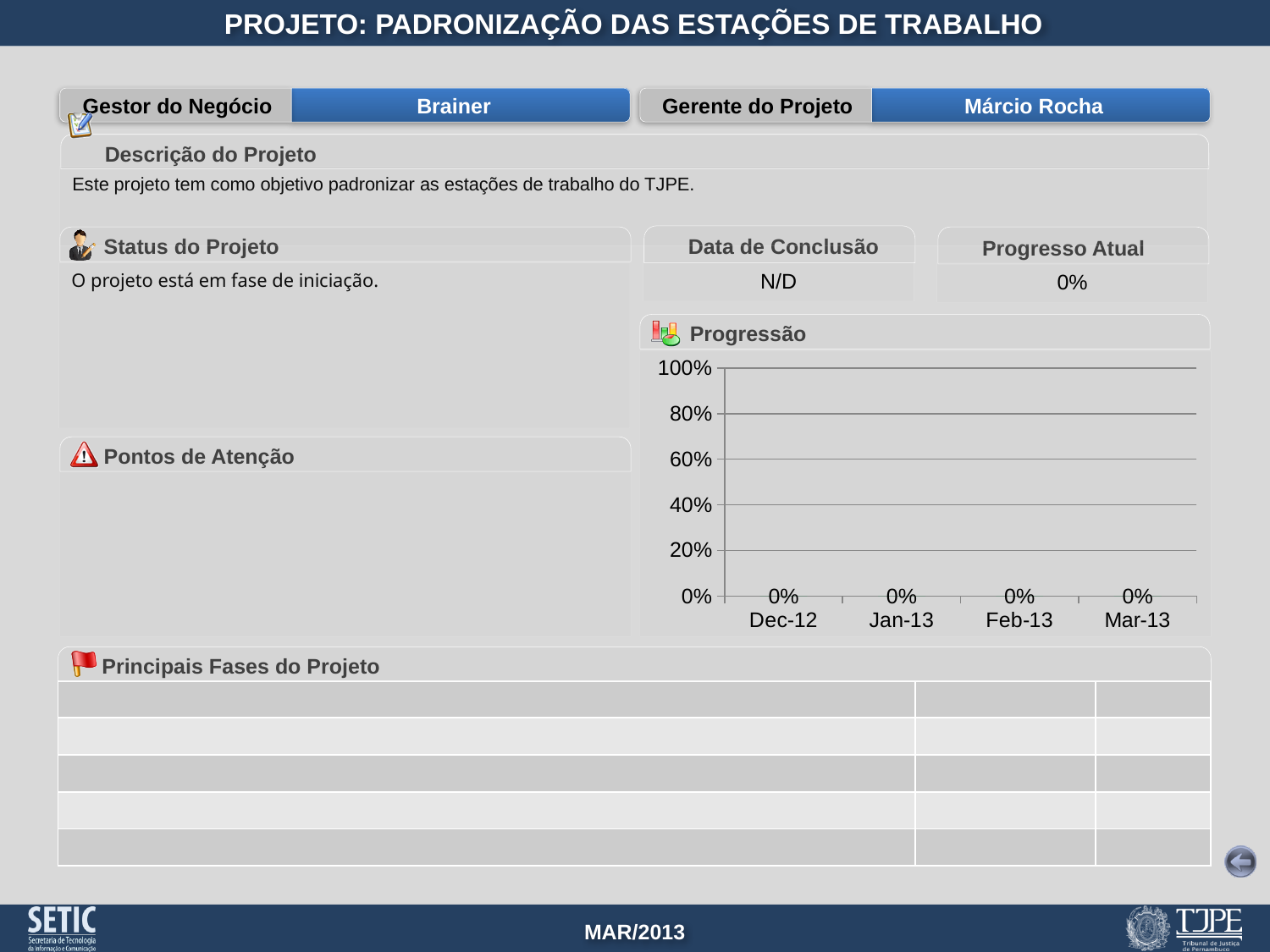
What is the first category on the x axis of the Progressão chart? Dec-12 Is the value for Feb-13 in the Progressão chart greater or less than 20%? less What is the last category on the x axis of the Progressão chart? Mar-13 What is the title of the chart on the slide? Progressão What is the value for Mar-13 in the Progressão chart? 0% How many categories are shown on the x axis of the Progressão chart? 4 What is the value for Dec-12 in the Progressão chart? 0% What is the highest value shown on the y axis of the Progressão chart? 100% Do the values in the Progressão chart rise, fall, or stay flat from Dec-12 to Mar-13? stay flat What is the difference between the values for Mar-13 and Dec-12 in the Progressão chart? 0% What is the value for Jan-13 in the Progressão chart? 0% What is the value for Feb-13 in the Progressão chart? 0%